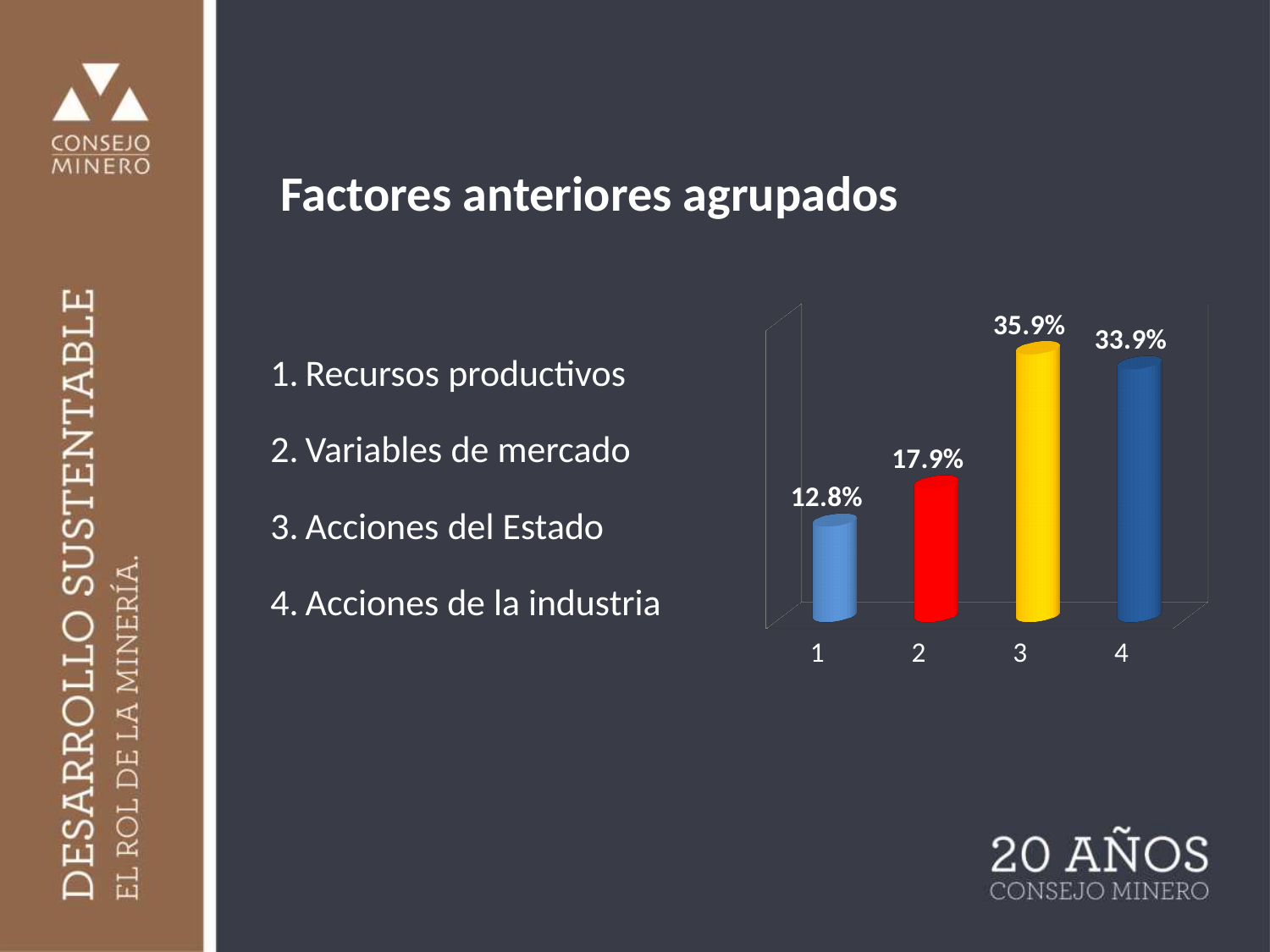
What is the value for category 2 in the chart? 17.9% What is the difference between the values for category 3 and category 4? 2.0% What is the difference between the values for category 2 and category 1? 5.1% Which is larger, the value for category 2 or the value for category 4? 4 What is the value for category 4 in the chart? 33.9% Which category has the highest value in the chart? 3 What is the value for category 3 in the chart? 35.9% How many categories are shown in the chart? 4 What colour is the bar for category 3? yellow Which category has the lowest value in the chart? 1 What kind of chart is shown on the slide? bar chart What is the value for category 1 in the chart? 12.8%